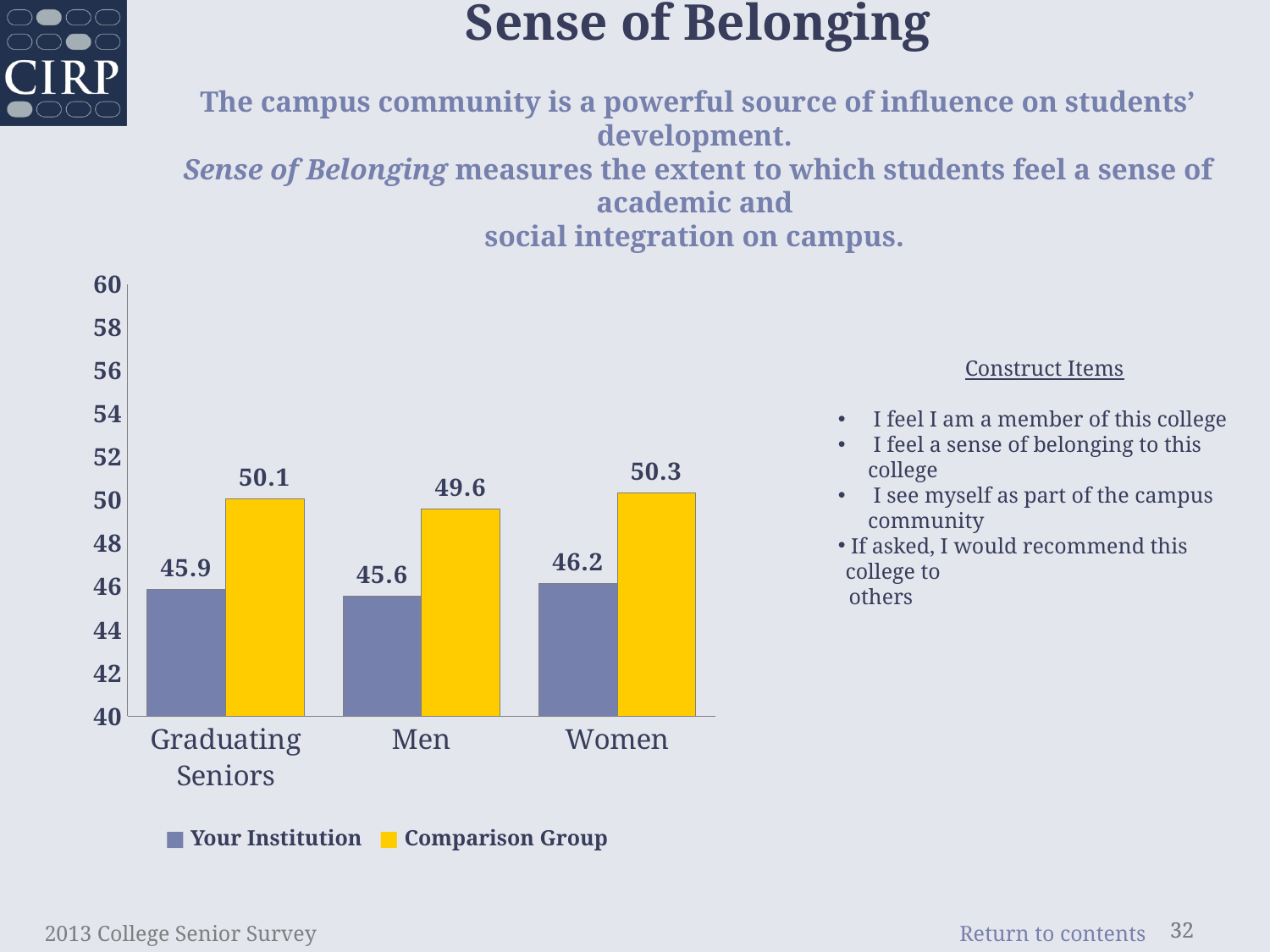
Which series is shown in yellow in the legend? Comparison Group How many series does the legend list? 2 What kind of chart is shown on the slide? bar chart What is the value for the Comparison Group for Men? 49.6 What is the difference between the Comparison Group and Your Institution values for Graduating Seniors? 4.2 What is the value for Your Institution for Women? 46.2 Which category has the lowest Your Institution value? Men Is the value for Your Institution for Men greater or less than 50? less What is the value for Your Institution for Graduating Seniors? 45.9 How many categories are shown on the x axis? 3 Which is larger for Women: Your Institution or the Comparison Group? Comparison Group Which category has the highest Comparison Group value? Women